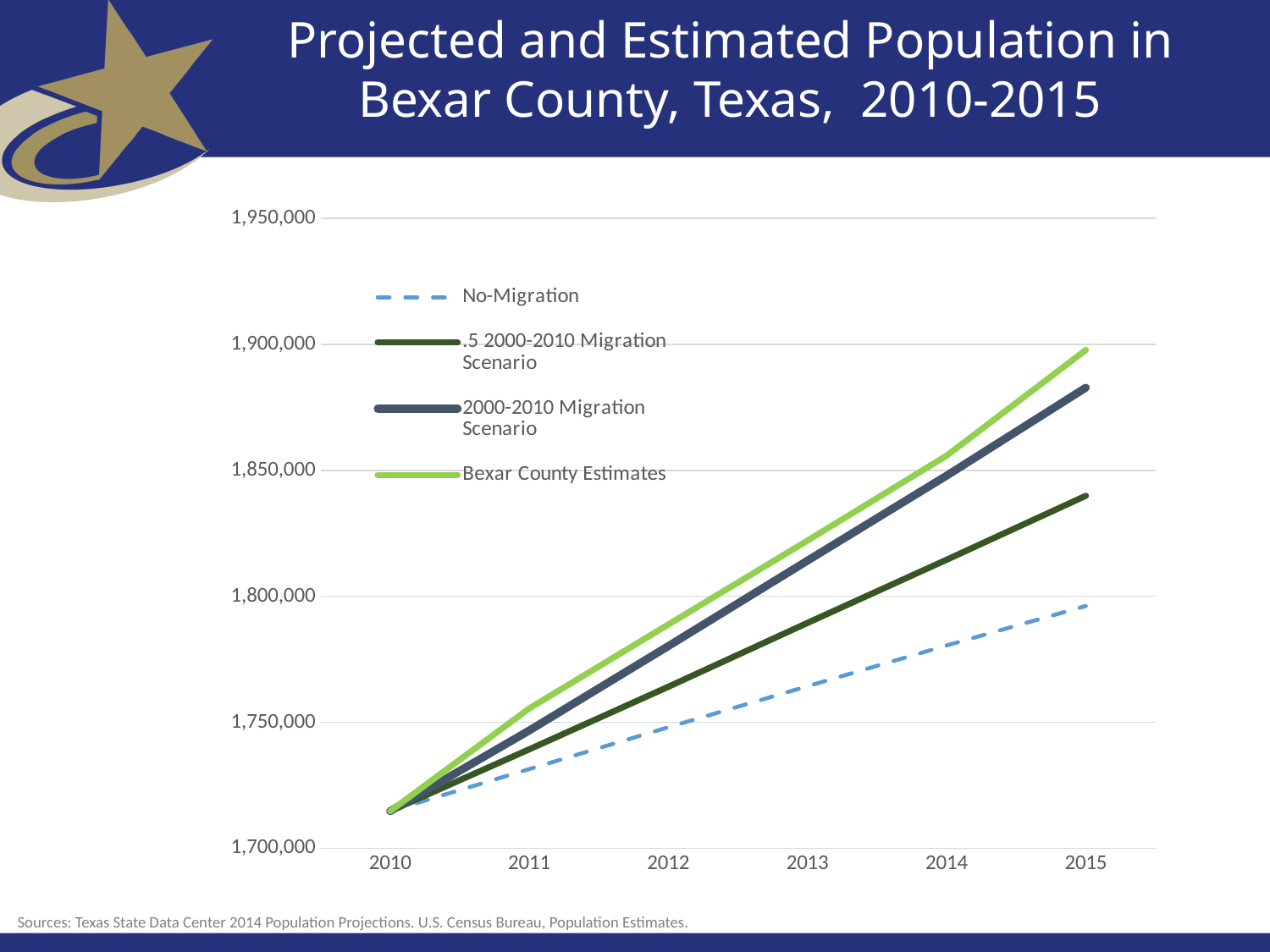
Is the value for the .5 2000-2010 Migration Scenario in 2015 greater or less than 1,850,000? less Is the value for the 2000-2010 Migration Scenario in 2015 greater or less than 1,850,000? greater Which series has the highest value in 2015? Bexar County Estimates Which series is drawn with a dashed line? No-Migration Which series has the lowest value in 2015? No-Migration How many series does the legend list? 4 Is the value for No-Migration in 2015 greater or less than 1,750,000? greater What kind of chart is shown on the slide? Line chart How many years are shown along the x axis? 6 Do the values for the Bexar County Estimates series rise or fall from 2010 to 2015? Rise In 2015, which is larger: the 2000-2010 Migration Scenario or the .5 2000-2010 Migration Scenario? 2000-2010 Migration Scenario